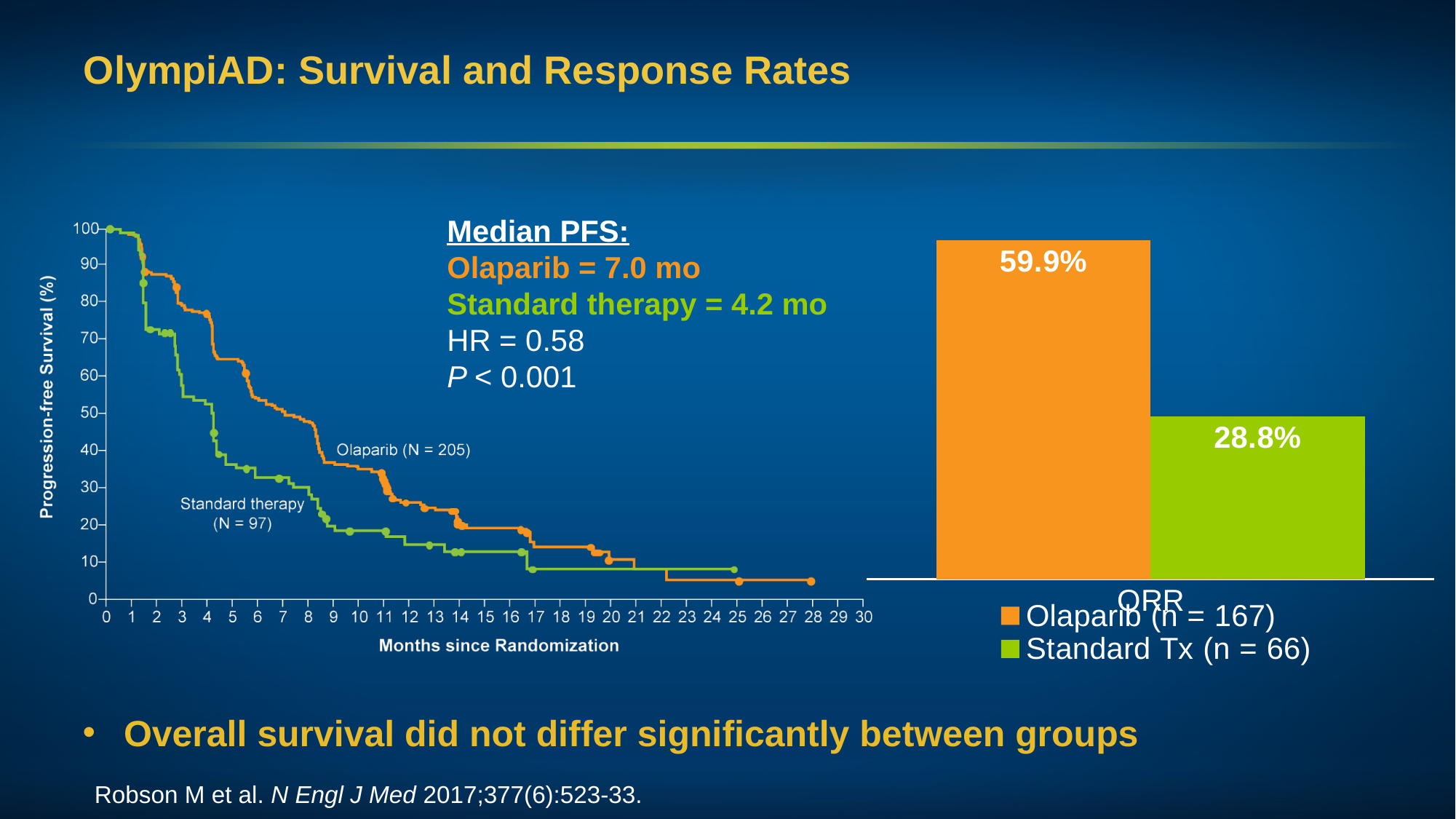
On the progression-free survival chart on the left, is the Olaparib curve at 5 months greater or less than 60%? greater On the bar chart on the right, what colour is the Standard Tx (n = 66) bar? Green On the progression-free survival chart on the left, is the Standard therapy curve at 5 months greater or less than 40%? less On the bar chart on the right, what is the difference in ORR between Olaparib and Standard Tx? 31.1% On the bar chart on the right, which group has the higher ORR? Olaparib (n = 167) On the bar chart on the right, how many series does the legend list? 2 What kind of chart is the chart on the right of the slide? Bar chart On the bar chart on the right, what is the ORR for Standard Tx (n = 66)? 28.8% On the progression-free survival chart on the left, do the curves rise or fall as months since randomization increase? Fall On the progression-free survival chart on the left, what is the label of the x axis? Months since Randomization On the progression-free survival chart on the left, how many patients are in the Olaparib group? 205 On the bar chart on the right, what is the ORR for Olaparib (n = 167)? 59.9%